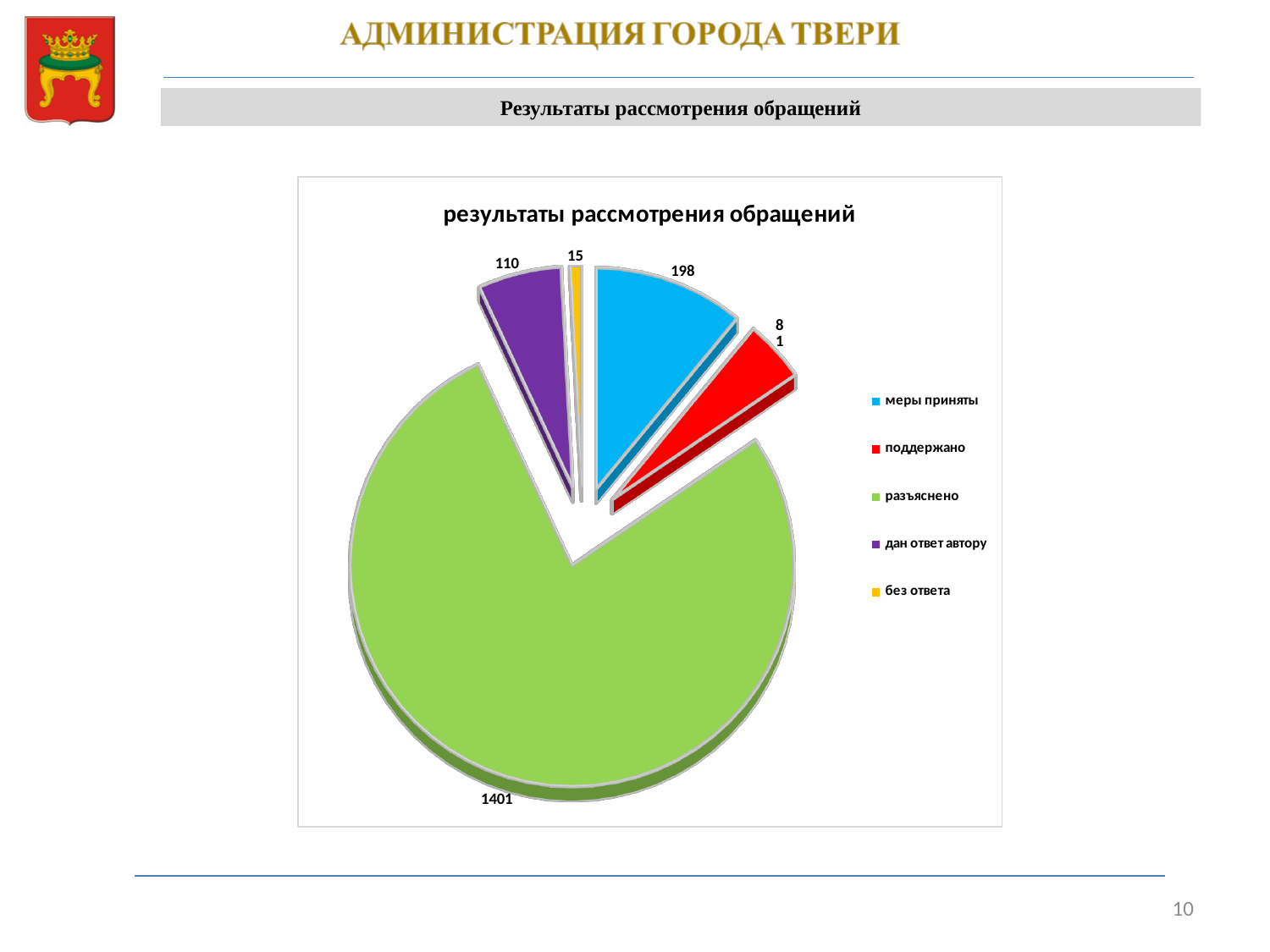
Which category has the smallest slice of the pie? без ответа What is the difference between the values for разъяснено and меры приняты? 1203 What is the value for разъяснено? 1401 What is the value for меры приняты? 198 How many categories does the legend list? 5 What is the value for без ответа? 15 What is the title of the chart? результаты рассмотрения обращений Which is larger, меры приняты or дан ответ автору? меры приняты Which category has the largest slice of the pie? разъяснено What is the difference between the values for меры приняты and дан ответ автору? 88 What kind of chart is shown on the slide? pie chart What is the value for дан ответ автору? 110